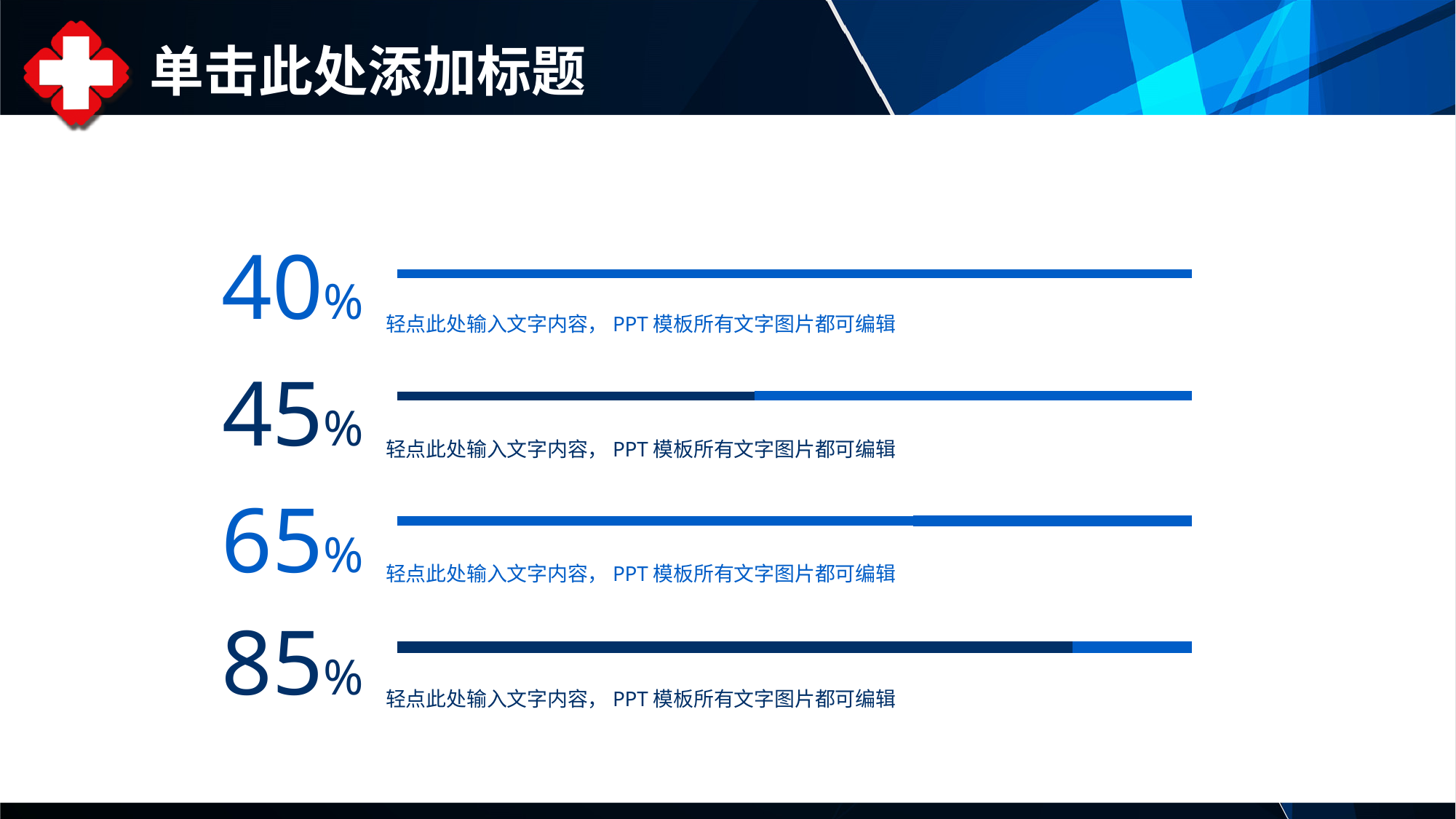
What percentage is shown for the first (top) bar? 40% What percentage is shown for the third bar from the top? 65% How many percentage bars are shown on the slide? 4 Do the percentages increase or decrease going from the top bar to the bottom bar? Increase Which bar has the highest percentage? The fourth (bottom) bar, 85% What percentage is shown for the second bar from the top? 45% What kind of chart is shown on the slide? Horizontal bar chart (progress bars) Which is larger, the percentage of the second bar or the third bar? The third bar (65%) What is the difference between the bottom bar's percentage and the top bar's percentage? 45% What percentage is shown for the fourth (bottom) bar? 85% Which bar has the lowest percentage? The first (top) bar, 40% What is the difference between the third bar's percentage and the second bar's percentage? 20%